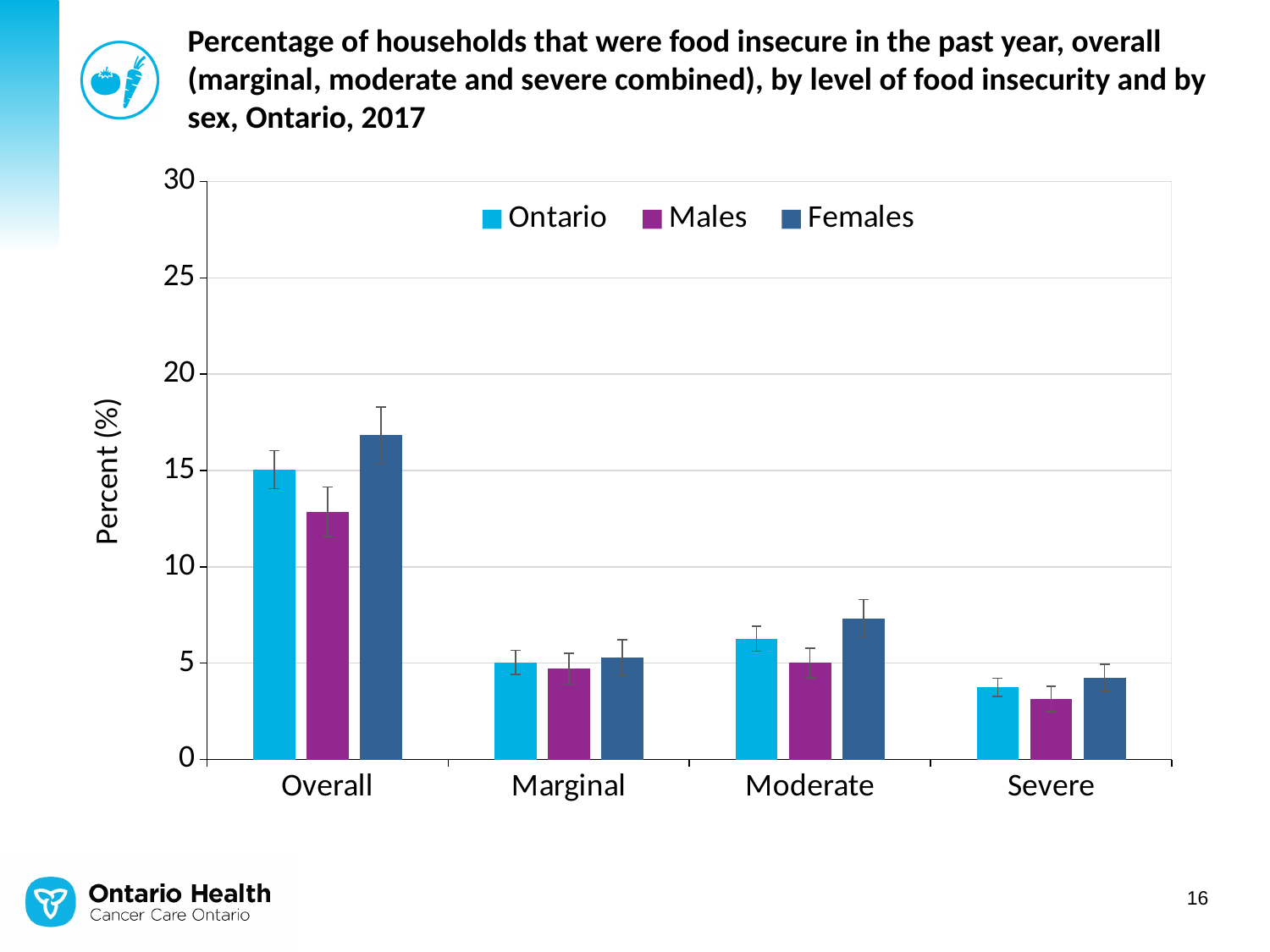
What kind of chart is shown on the slide? bar chart Is the value for Females in the Moderate category greater or less than 5? greater For the Ontario series, which category has the lowest bar? Severe Is the value for Females in the Overall category greater or less than 15? greater In the Moderate category, which is larger: the Males bar or the Females bar? Females Which series has the highest bar in the Overall category? Females How many categories are shown on the x axis? 4 For the Females series, which category has the highest bar? Overall Which series has the lowest bar in the Overall category? Males How many series does the legend list? 3 What is the label on the y axis? Percent (%) Is the value for Males in the Overall category greater or less than 15? less